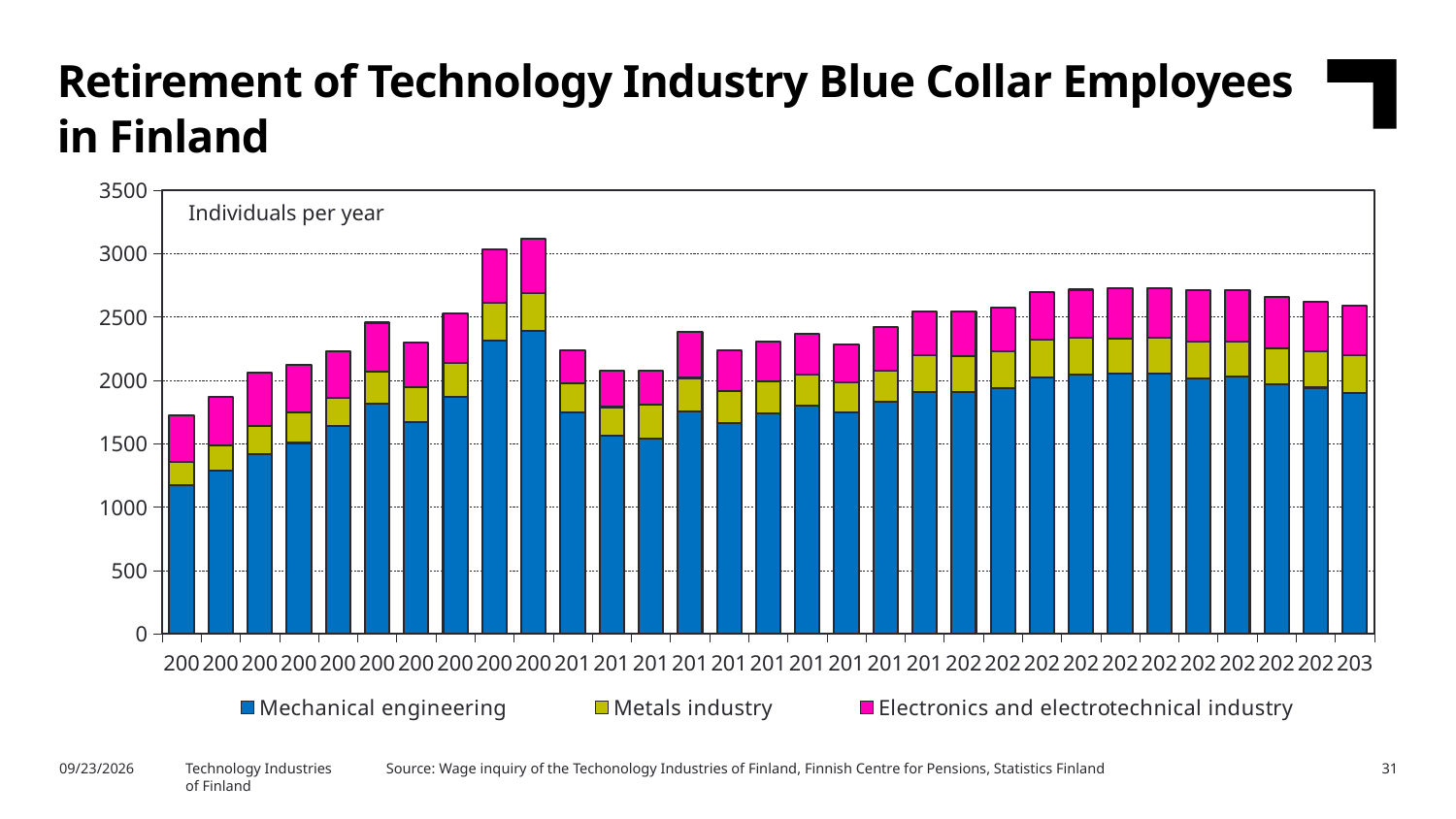
Is the Mechanical engineering segment of the tallest bar greater or less than 2000? greater What type of chart is shown on the slide? Stacked bar chart Which series contributes the largest segment in every bar? Mechanical engineering In the tallest bar, which segment is larger: Mechanical engineering or Metals industry? Mechanical engineering What unit label is shown inside the chart area? Individuals per year Is the total of the last bar on the right greater or less than 2500? greater Is the total of the tallest bar greater or less than 3000? greater Which series is shown in pink (magenta)? Electronics and electrotechnical industry How many bars (years) are plotted in the chart? 31 How many series does the legend list? 3